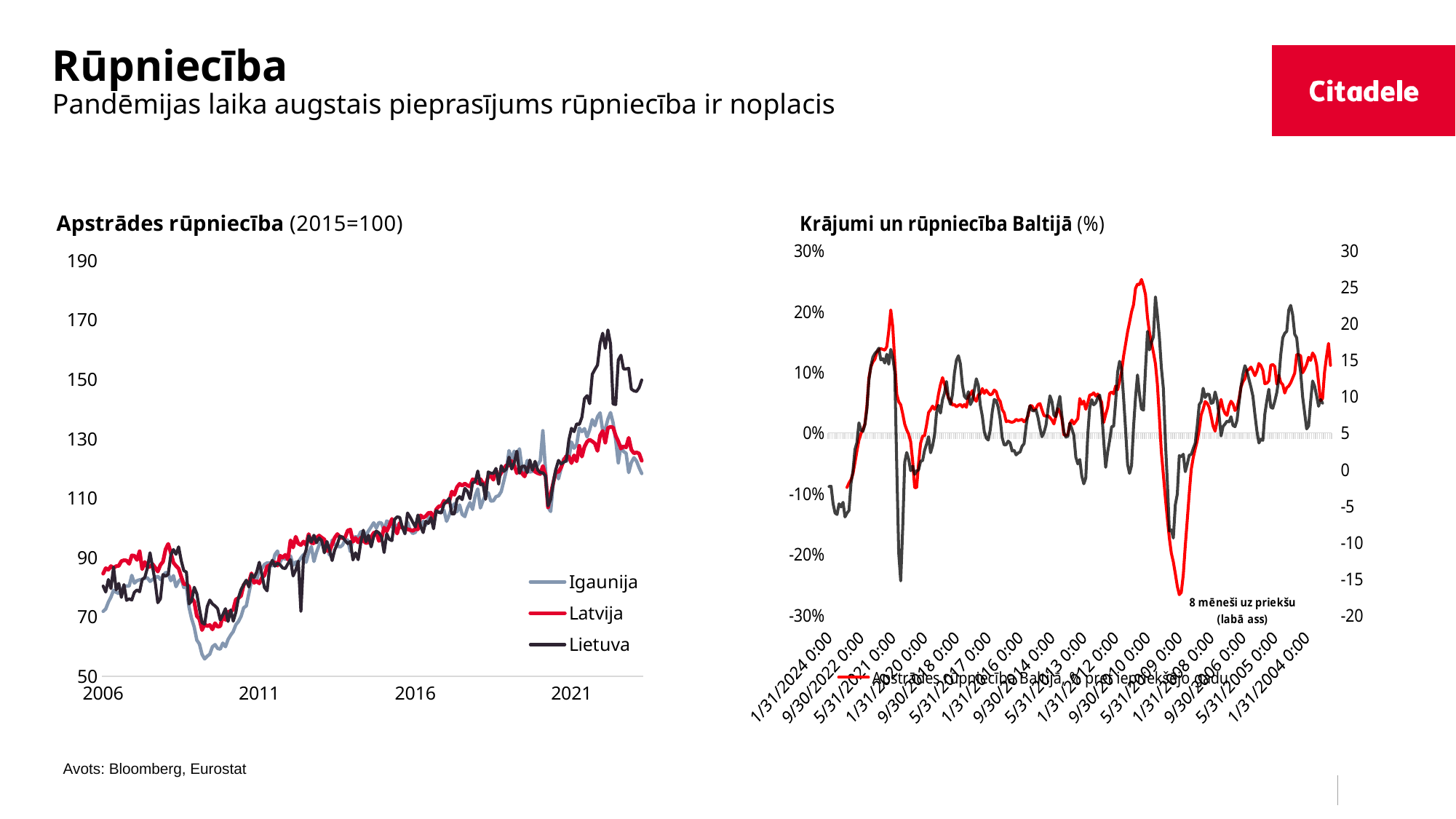
What is the title of the right chart? Krājumi un rūpniecība Baltijā (%) In the left chart 'Apstrādes rūpniecība', is the lowest value of Igaunija around 2009 greater or less than 70? less How many lines are plotted in the right chart 'Krājumi un rūpniecība Baltijā'? 2 In the right chart 'Krājumi un rūpniecība Baltijā', is the lowest point of the red line greater or less than -20% on the left axis? less In the left chart 'Apstrādes rūpniecība', which series is highest at the right end of the chart (around 2023)? Lietuva In the right chart 'Krājumi un rūpniecība Baltijā', is the highest peak of the red line greater or less than 20% on the left axis? greater In the left chart 'Apstrādes rūpniecība', which colour represents Latvija in the legend? red In the left chart 'Apstrādes rūpniecība', which series falls lowest during the 2009 dip? Igaunija In the left chart 'Apstrādes rūpniecība', do the values generally rise or fall from 2006 to 2021? rise What kind of chart is the left chart titled 'Apstrādes rūpniecība (2015=100)'? line chart How many series does the legend of the left chart 'Apstrādes rūpniecība' list? 3